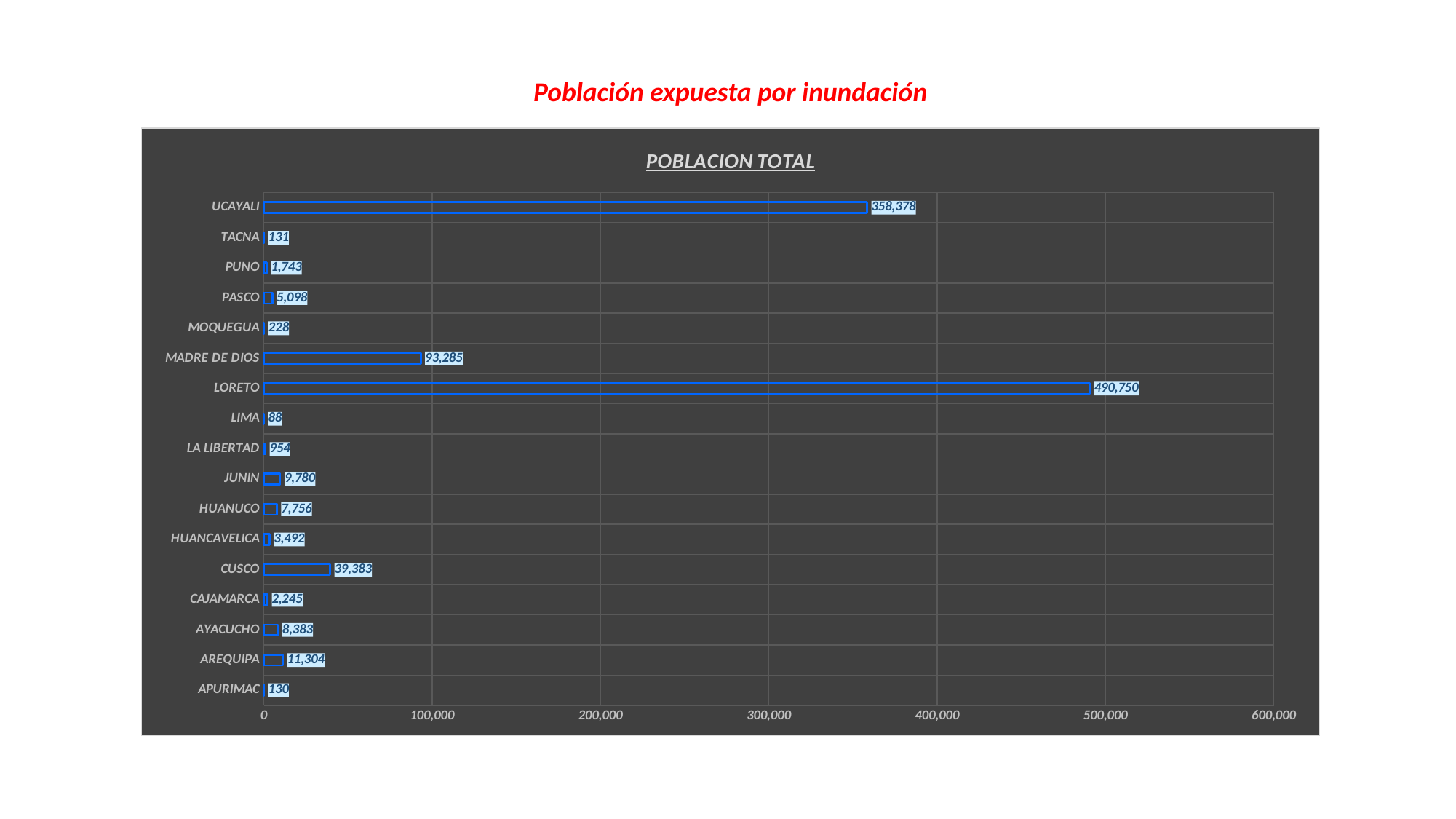
What is the value for LORETO? 490,750 What kind of chart is shown on the slide? bar chart What is the value for AREQUIPA? 11,304 Is the value for LORETO greater or less than 400,000? greater How many categories are shown in the chart? 17 What is the difference between the values for MADRE DE DIOS and CUSCO? 53,902 Which has a larger value, CUSCO or MADRE DE DIOS? MADRE DE DIOS What is the value for MADRE DE DIOS? 93,285 Which category has the highest value? LORETO What is the difference between the values for LORETO and UCAYALI? 132,372 What is the title of the chart? POBLACION TOTAL Which category has the lowest value? LIMA